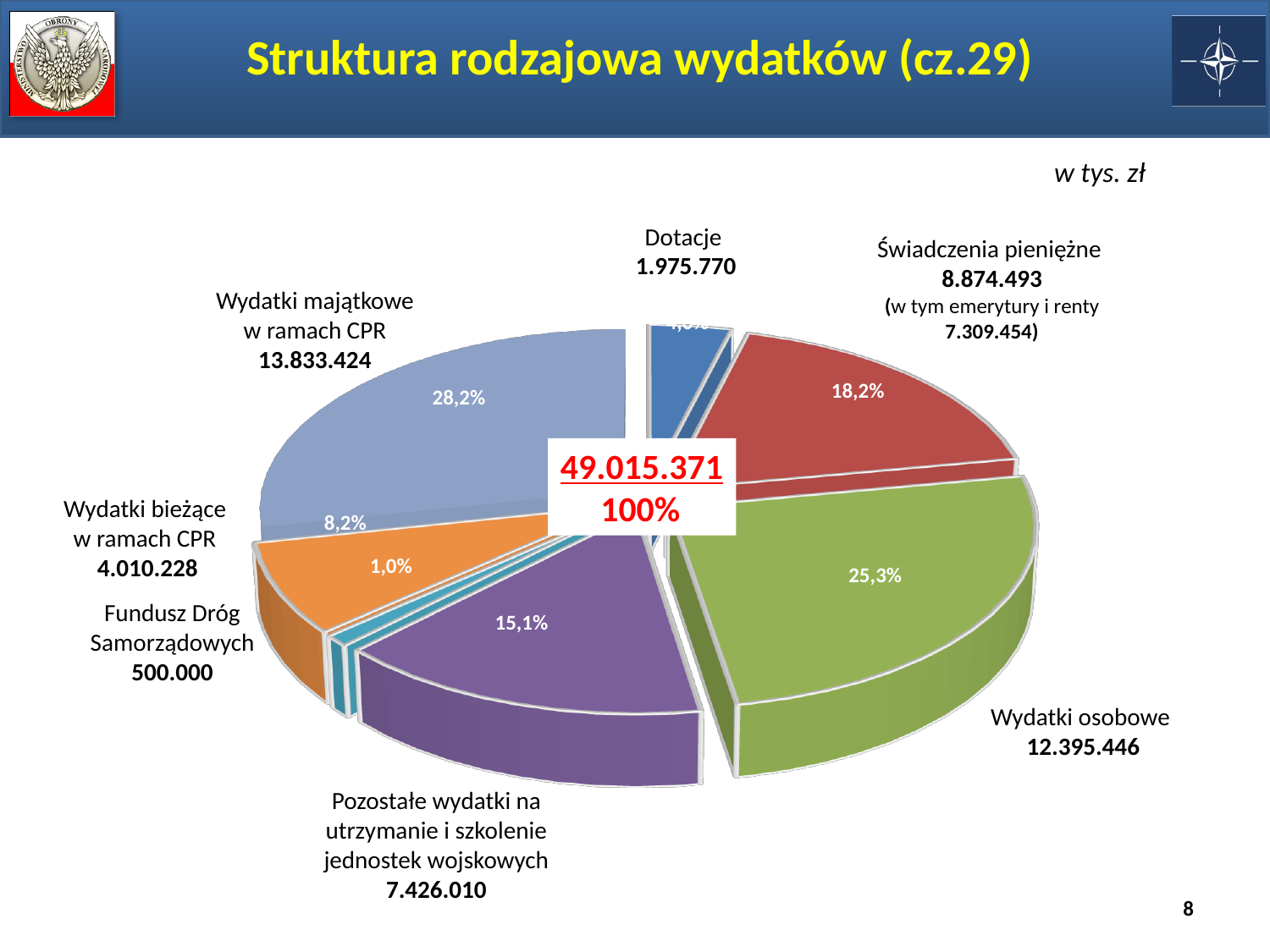
What is the value for Świadczenia pieniężne? 8.874.493 What is the difference between Wydatki majątkowe w ramach CPR and Wydatki osobowe? 1.437.978 What share of the pie does Wydatki osobowe represent? 25,3% Which is larger, Świadczenia pieniężne or Pozostałe wydatki na utrzymanie i szkolenie jednostek wojskowych? Świadczenia pieniężne What share of the pie does Wydatki bieżące w ramach CPR represent? 8,2% What is the value for Wydatki osobowe? 12.395.446 What is the value for Pozostałe wydatki na utrzymanie i szkolenie jednostek wojskowych? 7.426.010 What is the value for Fundusz Dróg Samorządowych? 500.000 What kind of chart is shown on the slide? pie chart Which category has the largest share of the pie? Wydatki majątkowe w ramach CPR Which category has the smallest share of the pie? Fundusz Dróg Samorządowych How many slices does the pie chart have? 7